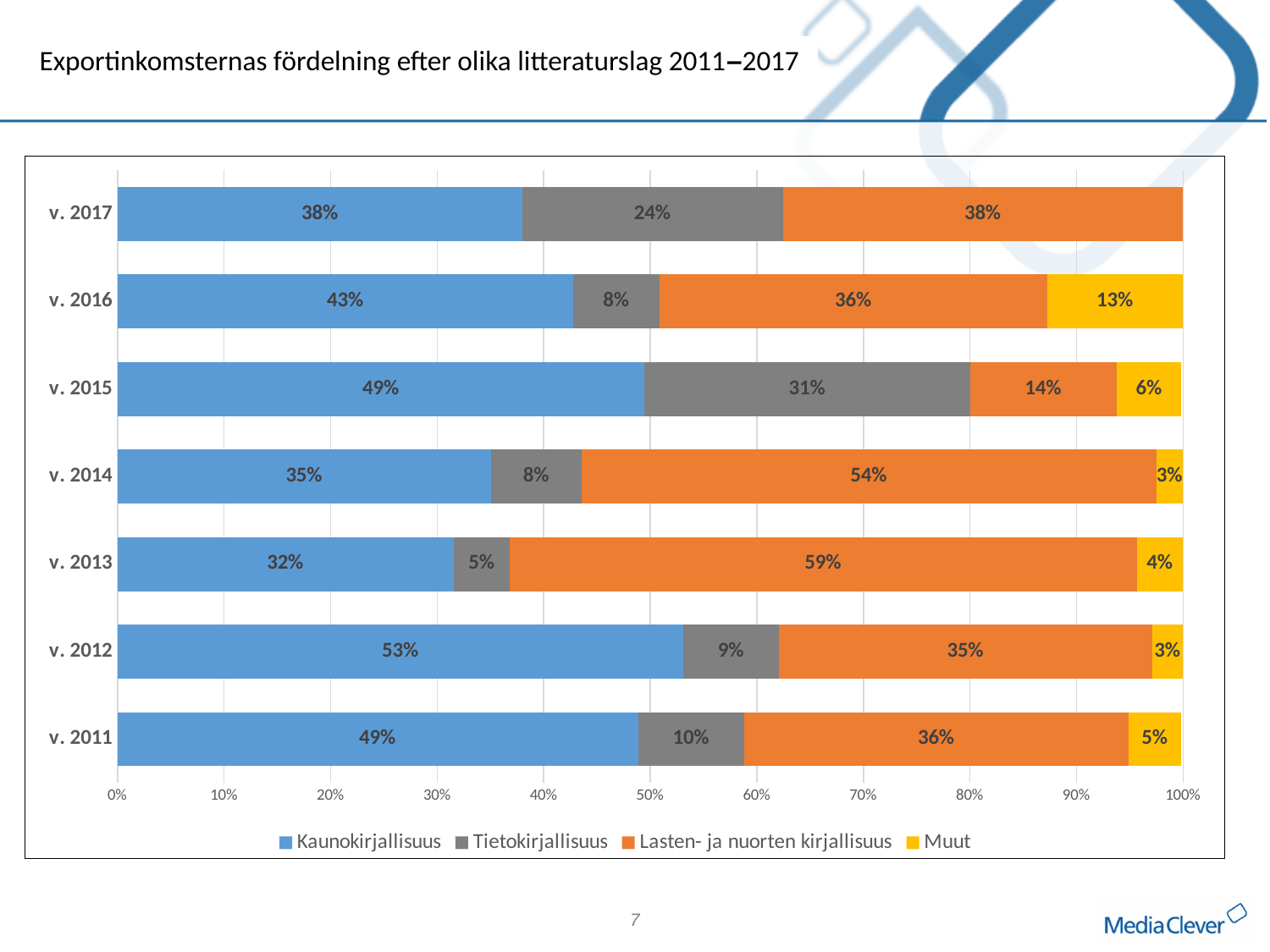
What is the title of the slide? Exportinkomsternas fördelning efter olika litteraturslag 2011–2017 Which is larger in v. 2016: Kaunokirjallisuus or Lasten- ja nuorten kirjallisuus? Kaunokirjallisuus What is the value for Lasten- ja nuorten kirjallisuus in v. 2013? 59% What is the difference between the Lasten- ja nuorten kirjallisuus share in v. 2014 and in v. 2015? 40% How many series does the legend list? 4 In which year is the Kaunokirjallisuus share the highest? v. 2012 In which year is the Tietokirjallisuus share the lowest? v. 2013 What kind of chart is shown on the slide? Stacked bar chart What is the value for Muut in v. 2016? 13% What is the value for Kaunokirjallisuus in v. 2017? 38% How many years are shown on the chart? 7 What is the value for Tietokirjallisuus in v. 2015? 31%